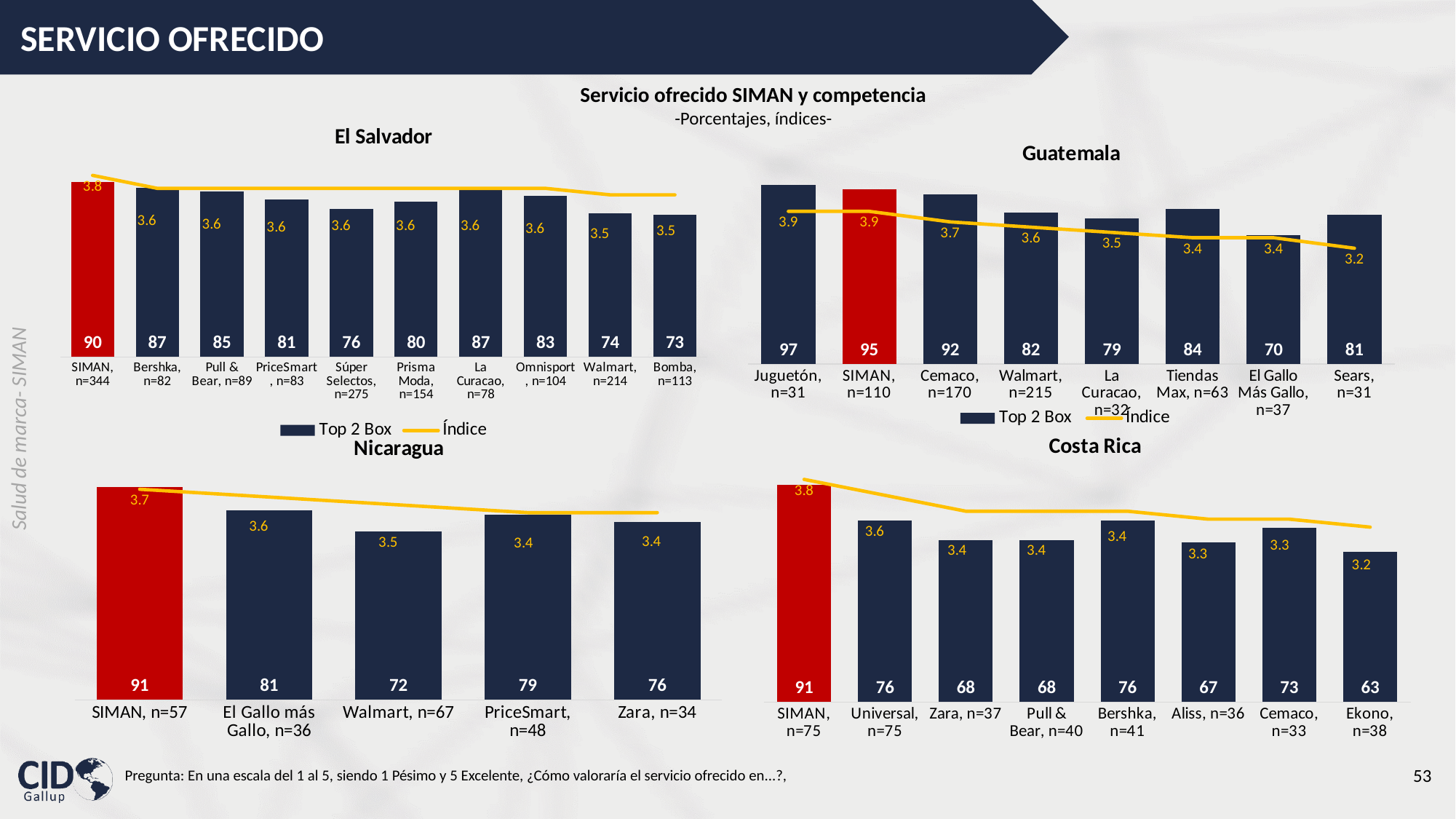
In the Nicaragua chart, what is the difference between the Top 2 Box values for SIMAN, n=57 and Walmart, n=67? 19 What is the overall title shown above the charts on the slide? Servicio ofrecido SIMAN y competencia How many categories are shown in the Nicaragua chart? 5 In the Guatemala chart, what is the Índice value for Sears, n=31? 3.2 In the El Salvador chart, which has a higher Top 2 Box value: Bershka, n=82 or Súper Selectos, n=275? Bershka, n=82 In the Guatemala chart, which category has the highest Top 2 Box value? Juguetón, n=31 What kind of chart is the Costa Rica chart? Bar chart with a line In the Costa Rica chart, what is the Índice value for SIMAN, n=75? 3.8 How many series does the legend of the El Salvador chart list? 2 How many categories are shown in the Guatemala chart? 8 In the Costa Rica chart, which category has the lowest Top 2 Box value? Ekono, n=38 In the El Salvador chart, what is the Top 2 Box value for SIMAN, n=344? 90